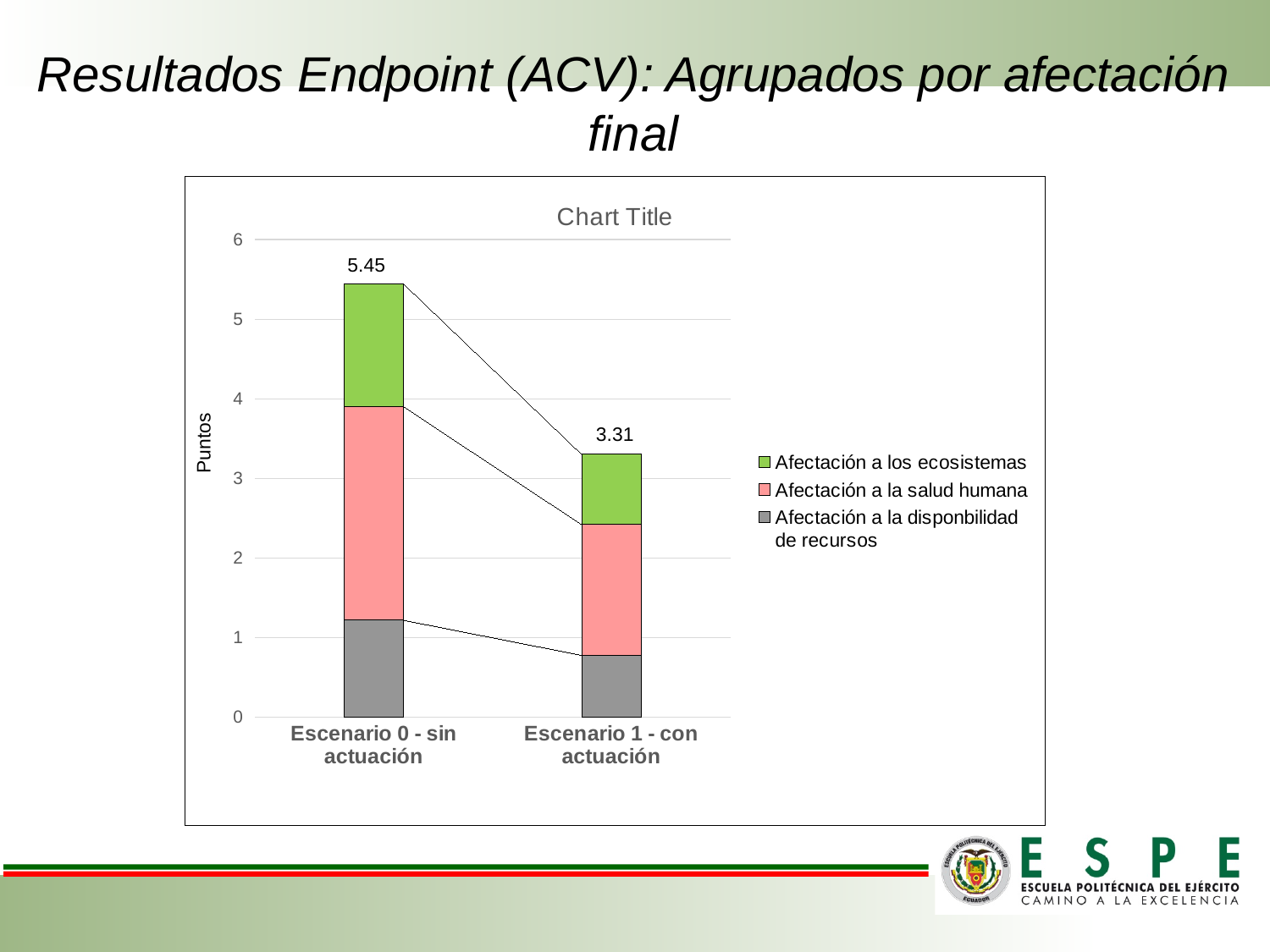
What type of chart is shown on the slide? stacked bar chart Which legend entry is shown in green? Afectación a los ecosistemas What is the difference between the total for Escenario 0 - sin actuación and the total for Escenario 1 - con actuación? 2.14 How many categories are shown on the x axis? 2 What is the total value of the bar for Escenario 1 - con actuación? 3.31 Is the 'Afectación a la disponbilidad de recursos' segment for Escenario 1 - con actuación greater or less than 1? less What is the label of the y axis? Puntos What is the total value of the bar for Escenario 0 - sin actuación? 5.45 Which scenario has the lower total value? Escenario 1 - con actuación Which scenario has the higher total value? Escenario 0 - sin actuación Is the total value for Escenario 0 - sin actuación greater or less than 5? greater How many series does the legend list? 3